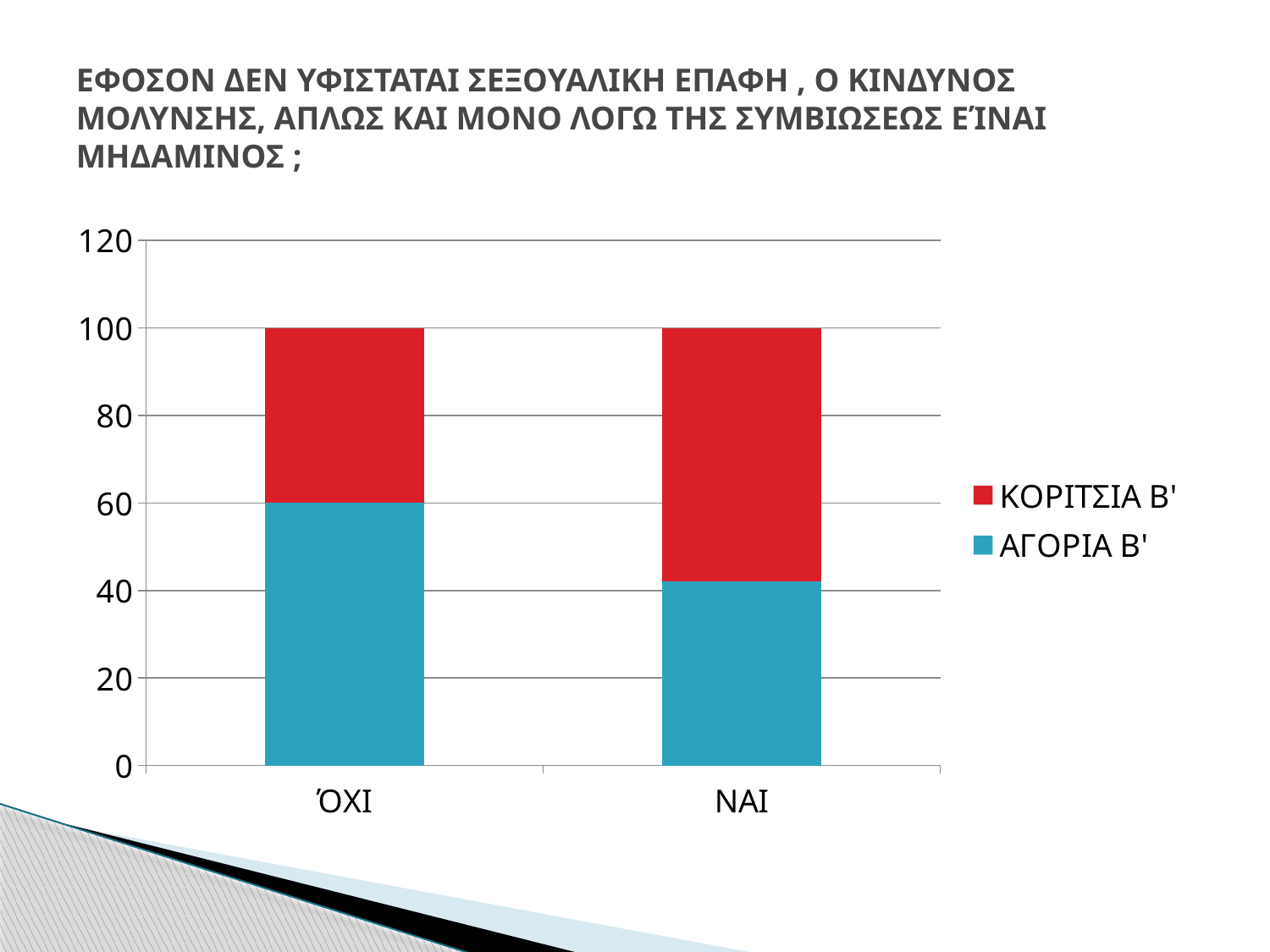
Is the value of ΑΓΟΡΙΑ Β' for ΝΑΙ greater or less than 60? less What is the total of the stacked bar for ΝΑΙ? 100 What type of chart is shown on the slide? Stacked bar chart For which category is the ΑΓΟΡΙΑ Β' value larger, ΌΧΙ or ΝΑΙ? ΌΧΙ What is the value of ΑΓΟΡΙΑ Β' for ΌΧΙ? 60 Which colour represents ΚΟΡΙΤΣΙΑ Β' in the chart? Red What is the total of the stacked bar for ΌΧΙ? 100 What is the highest value shown on the y axis? 120 Is the ΚΟΡΙΤΣΙΑ Β' segment for ΝΑΙ greater or less than 40? greater How many categories are shown on the x axis? 2 For which category is the ΚΟΡΙΤΣΙΑ Β' segment larger, ΌΧΙ or ΝΑΙ? ΝΑΙ How many series does the legend list? 2